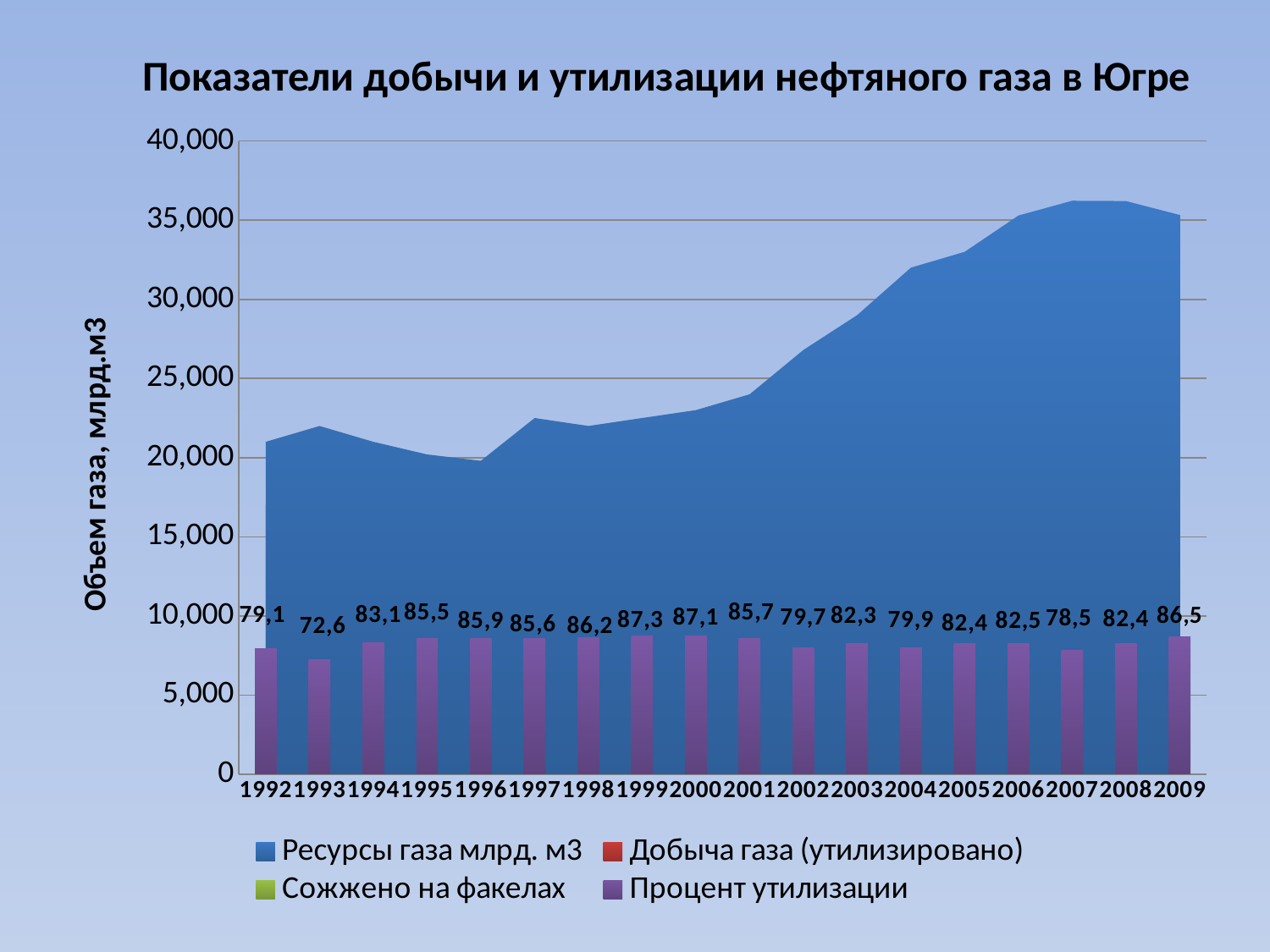
What is the value of Процент утилизации for 2009? 86,5 What is the value of Процент утилизации for 1993? 72,6 Does the Ресурсы газа млрд. м3 area rise or fall from 2001 to 2007? rise What is the value of Процент утилизации for 1999? 87,3 Which year has a higher Процент утилизации, 1994 or 1995? 1995 Is the value of Ресурсы газа млрд. м3 for 2002 greater or less than 25,000? greater What is the difference between the Процент утилизации values for 1999 and 1993? 14,7 Is the value of Ресурсы газа млрд. м3 for 1993 greater or less than 25,000? less How many years are shown on the x axis? 18 How many series does the legend list? 4 Which year has the highest Процент утилизации? 1999 Which year has the lowest Процент утилизации? 1993